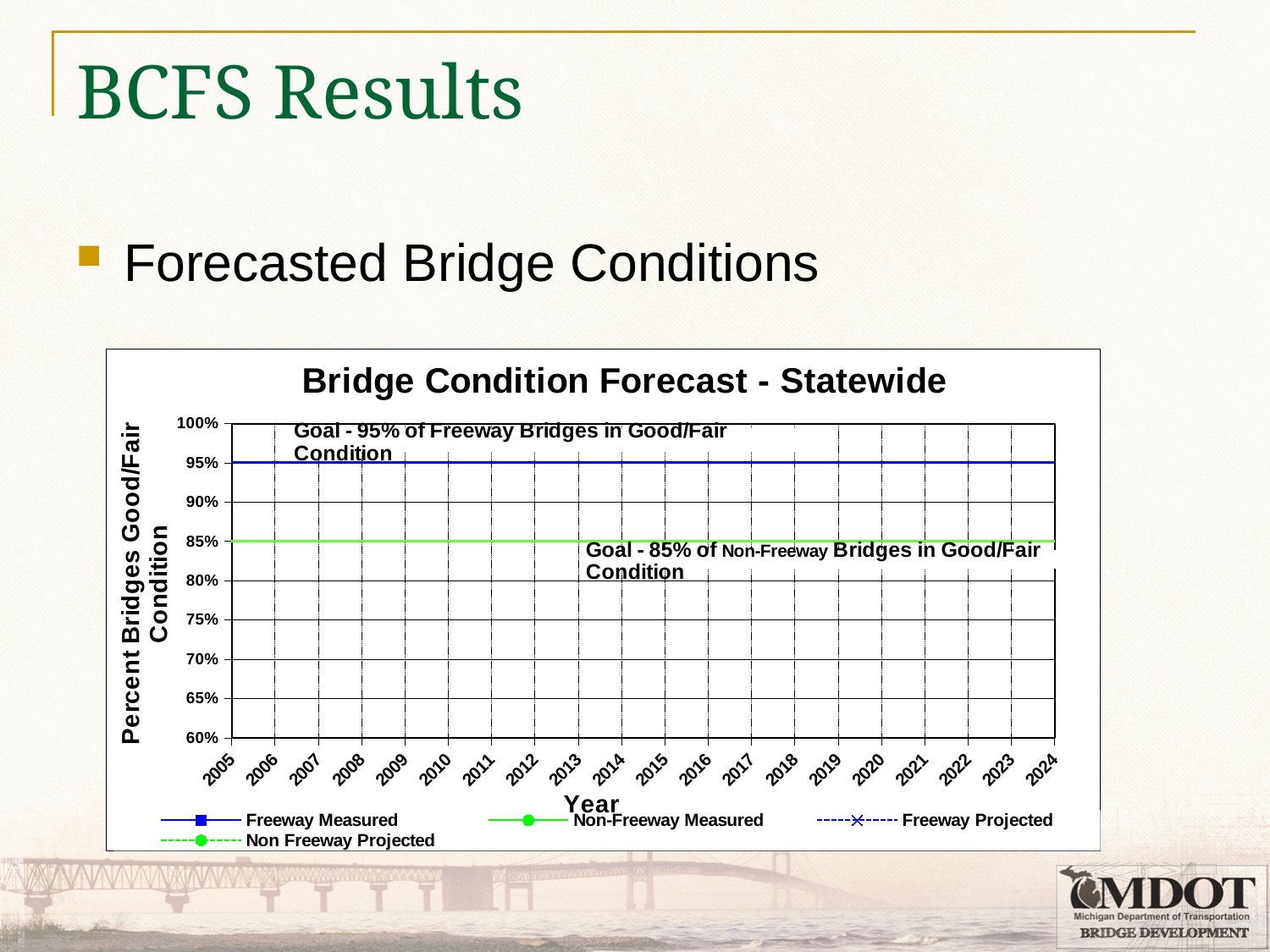
What is the first year shown on the x axis? 2005 Is the non-freeway goal line greater or less than 90%? less What kind of chart is shown on the slide? line chart What is the title of the chart? Bridge Condition Forecast - Statewide Do the goal lines rise, fall, or stay flat across the years on the x axis? stay flat How many years are labeled along the x axis? 20 What is the goal percentage of freeway bridges in good/fair condition shown on the chart? 95% What is the difference between the freeway goal and the non-freeway goal shown on the chart? 10% How many series does the chart's legend list? 4 What is the goal percentage of non-freeway bridges in good/fair condition shown on the chart? 85% What is the label of the vertical axis? Percent Bridges Good/Fair Condition Which goal line is higher, the freeway goal or the non-freeway goal? Freeway goal